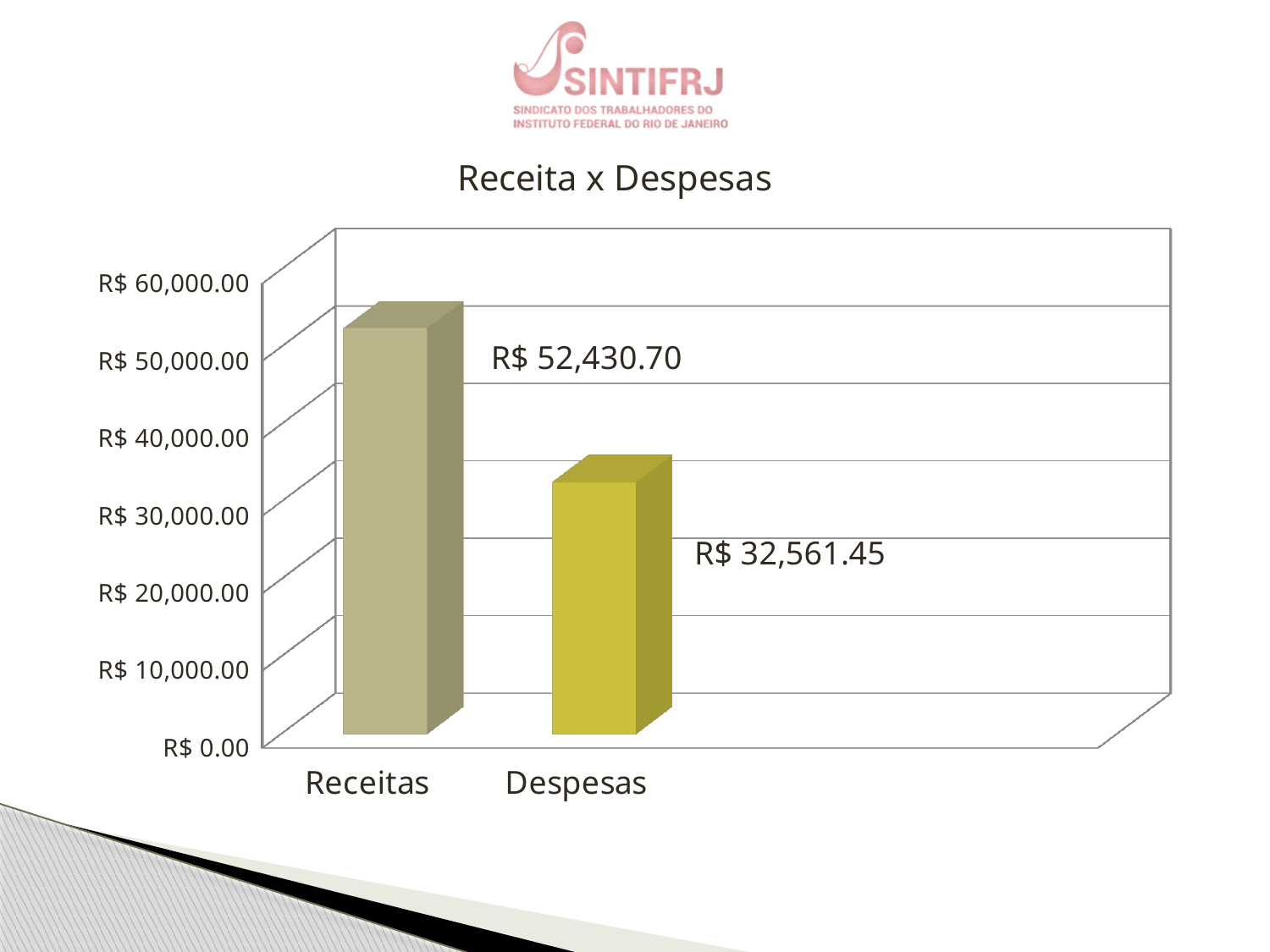
What kind of chart is shown on the slide? bar chart What is the title of the chart? Receita x Despesas Which category has the highest value? Receitas What is the value for Despesas? R$ 32,561.45 How many categories are shown on the chart? 2 What is the highest value shown on the vertical axis? R$ 60,000.00 Is the value for Despesas greater or less than R$ 40,000.00? less What is the value for Receitas? R$ 52,430.70 Which is larger, Receitas or Despesas? Receitas What is the difference between Receitas and Despesas? R$ 19,869.25 Which category has the lowest value? Despesas Is the value for Receitas greater or less than R$ 50,000.00? greater